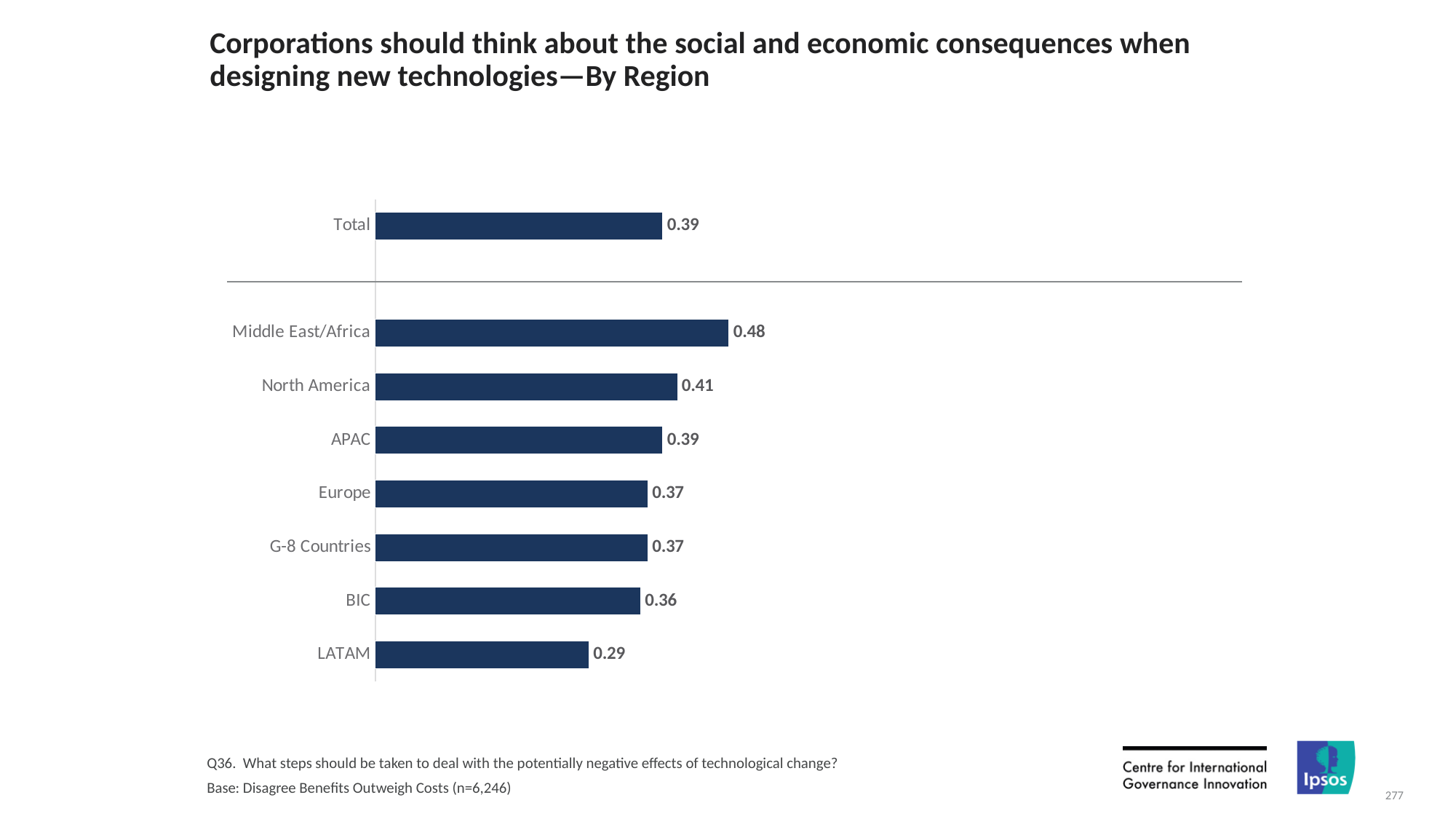
What is the value for BIC? 0.36 What is the value for Middle East/Africa? 0.48 What is the value for the Total bar? 0.39 What is the value for North America? 0.41 What is the value for LATAM? 0.29 How many bars are shown in the chart, including Total? 8 Which has a larger value, North America or Europe? North America What is the difference between the values for North America and APAC? 0.02 Which region has the lowest value? LATAM What kind of chart is shown on the slide? Bar chart Which region has the highest value? Middle East/Africa What is the difference between the values for Middle East/Africa and LATAM? 0.19